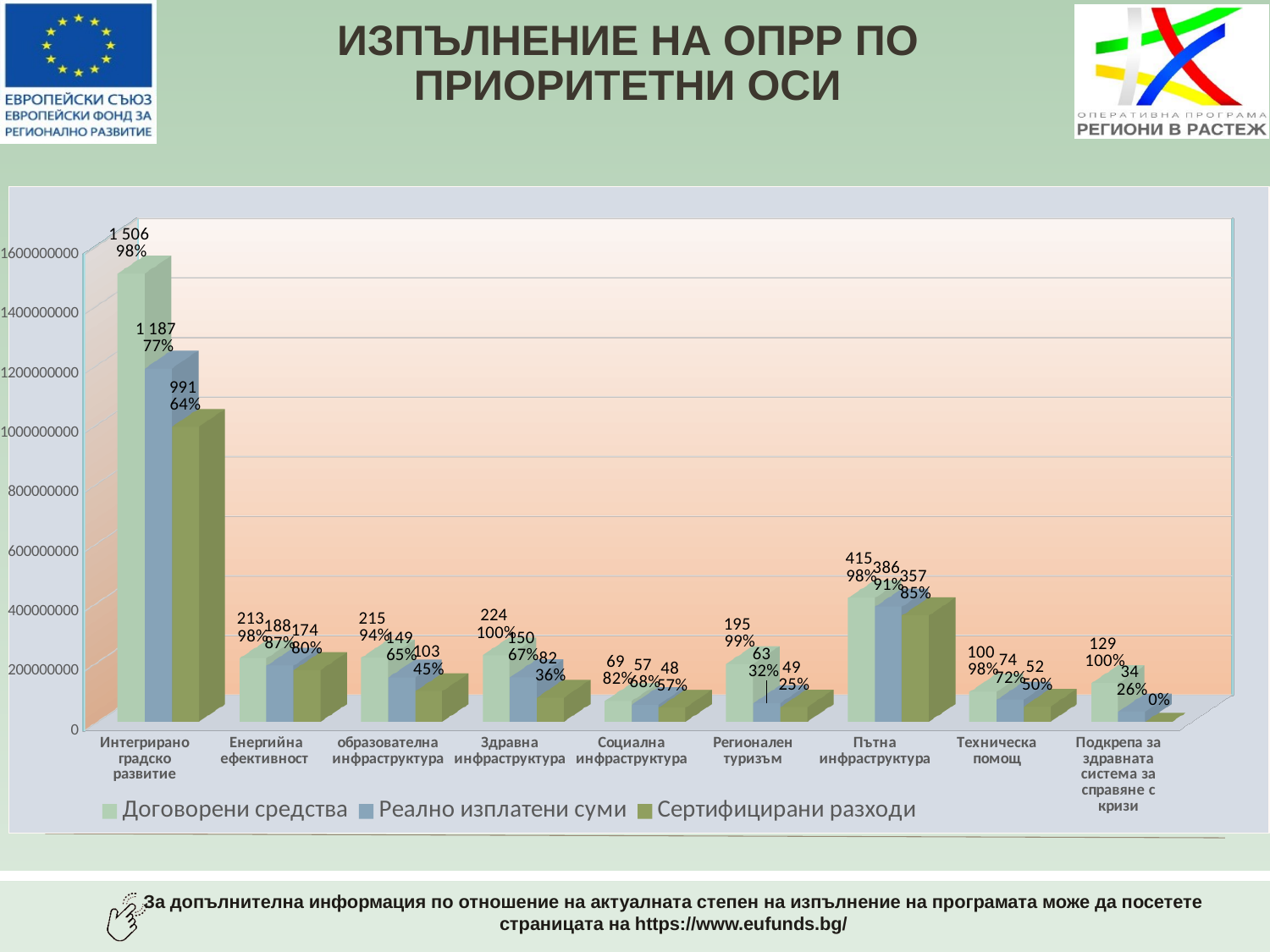
What type of chart is shown on the slide? bar chart What is the value of Договорени средства for Интегрирано градско развитие? 1 506 Which category has the lowest value of Договорени средства? Социална инфраструктура What percentage is shown for Сертифицирани разходи for Интегрирано градско развитие? 64% Which is larger: Сертифицирани разходи for Енергийна ефективност or for Техническа помощ? Енергийна ефективност How many series does the legend list? 3 What percentage is shown for Реално изплатени суми for Регионален туризъм? 32% How many categories (priority axes) are shown on the x axis? 9 What is the title of the slide? ИЗПЪЛНЕНИЕ НА ОПРР ПО ПРИОРИТЕТНИ ОСИ Which category has the highest value of Договорени средства? Интегрирано градско развитие What is the difference between Договорени средства and Реално изплатени суми for Здравна инфраструктура? 74 What is the value of Реално изплатени суми for Пътна инфраструктура? 386